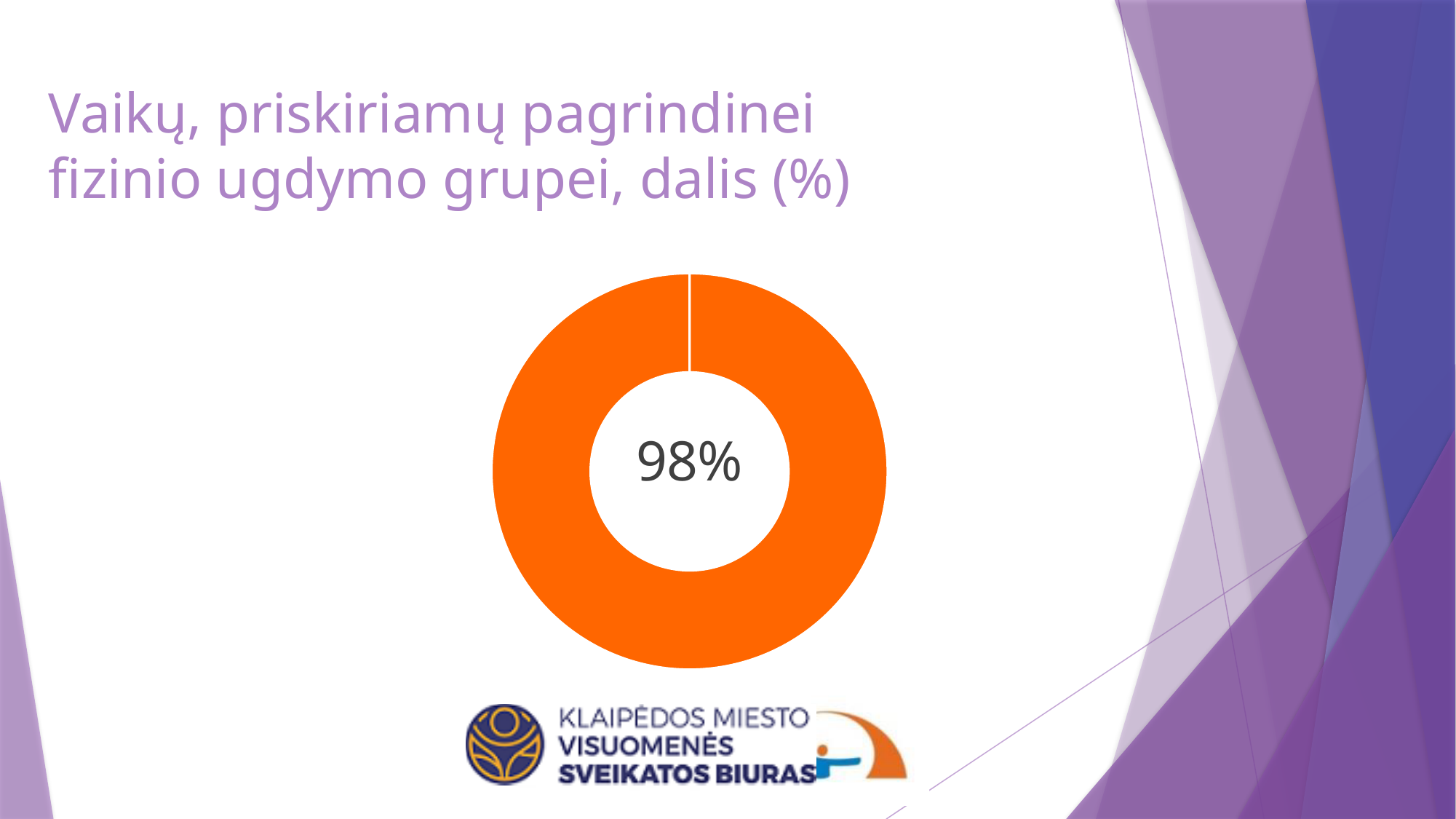
What share of children are assigned to the main physical education group according to the chart? 98% What is the title of the slide containing the chart? Vaikų, priskiriamų pagrindinei fizinio ugdymo grupei, dalis (%) What percentage is displayed in the centre of the doughnut chart? 98% Is the value shown on the doughnut chart greater or less than 50%? greater Is the value shown on the doughnut chart greater or less than 90%? greater What colour is the ring of the doughnut chart? orange What kind of chart is shown on the slide? doughnut chart